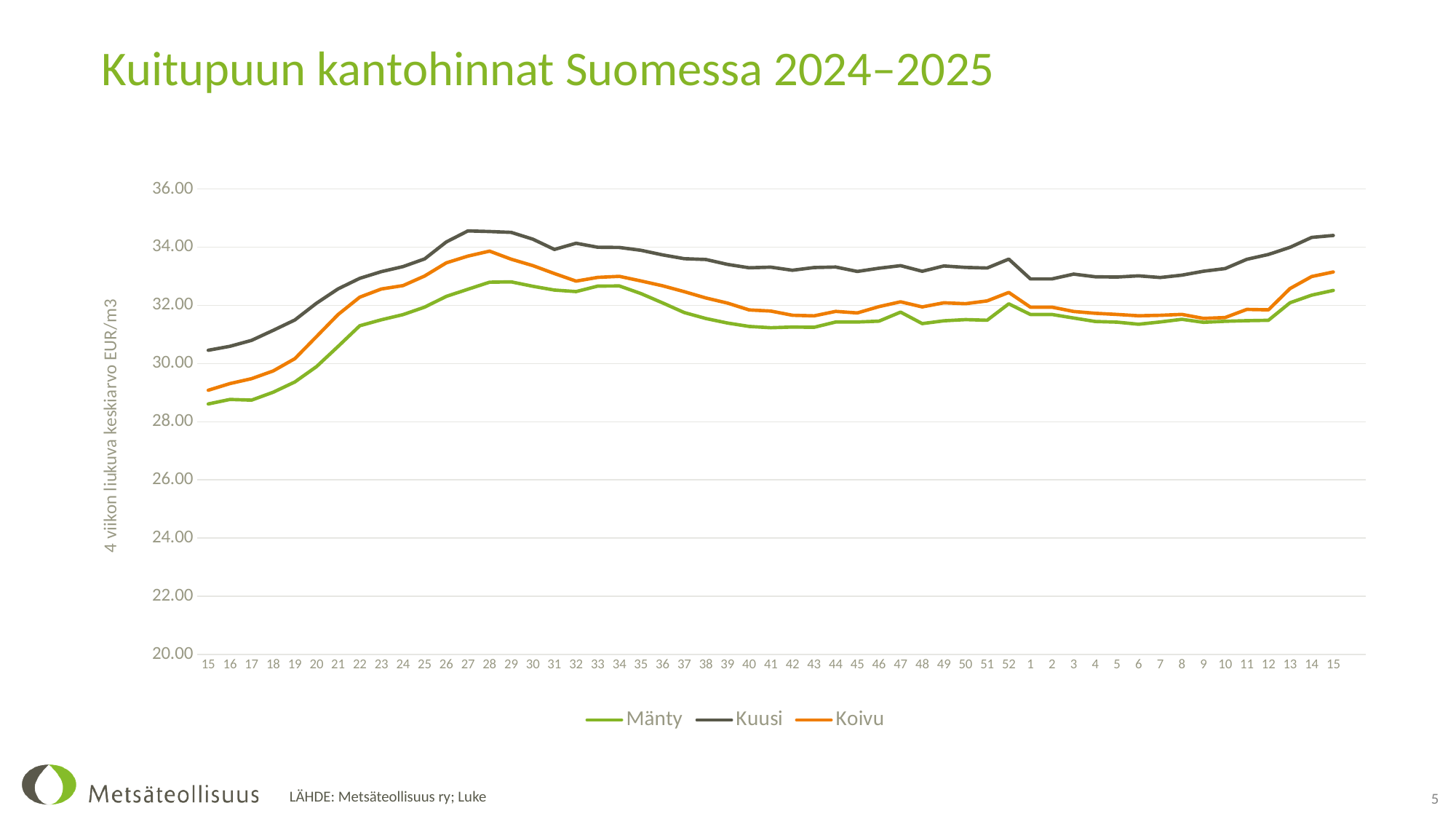
Is the value for Kuusi at week 1 greater or less than 34.00? less Is the value for Mänty at week 41 greater or less than 32.00? less Which series has the highest value at week 27, Kuusi or Mänty? Kuusi What is the title of the chart? Kuitupuun kantohinnat Suomessa 2024–2025 Which series has the lowest value at week 15? Mänty Which series has the highest values across the whole chart? Kuusi Does the Kuusi line rise or fall from week 15 to week 27? rise What kind of chart is shown on the slide? line chart Is the value for Kuusi at week 27 greater or less than 34.00? greater How many series does the legend list? 3 Which series are listed in the legend? Mänty, Kuusi, Koivu